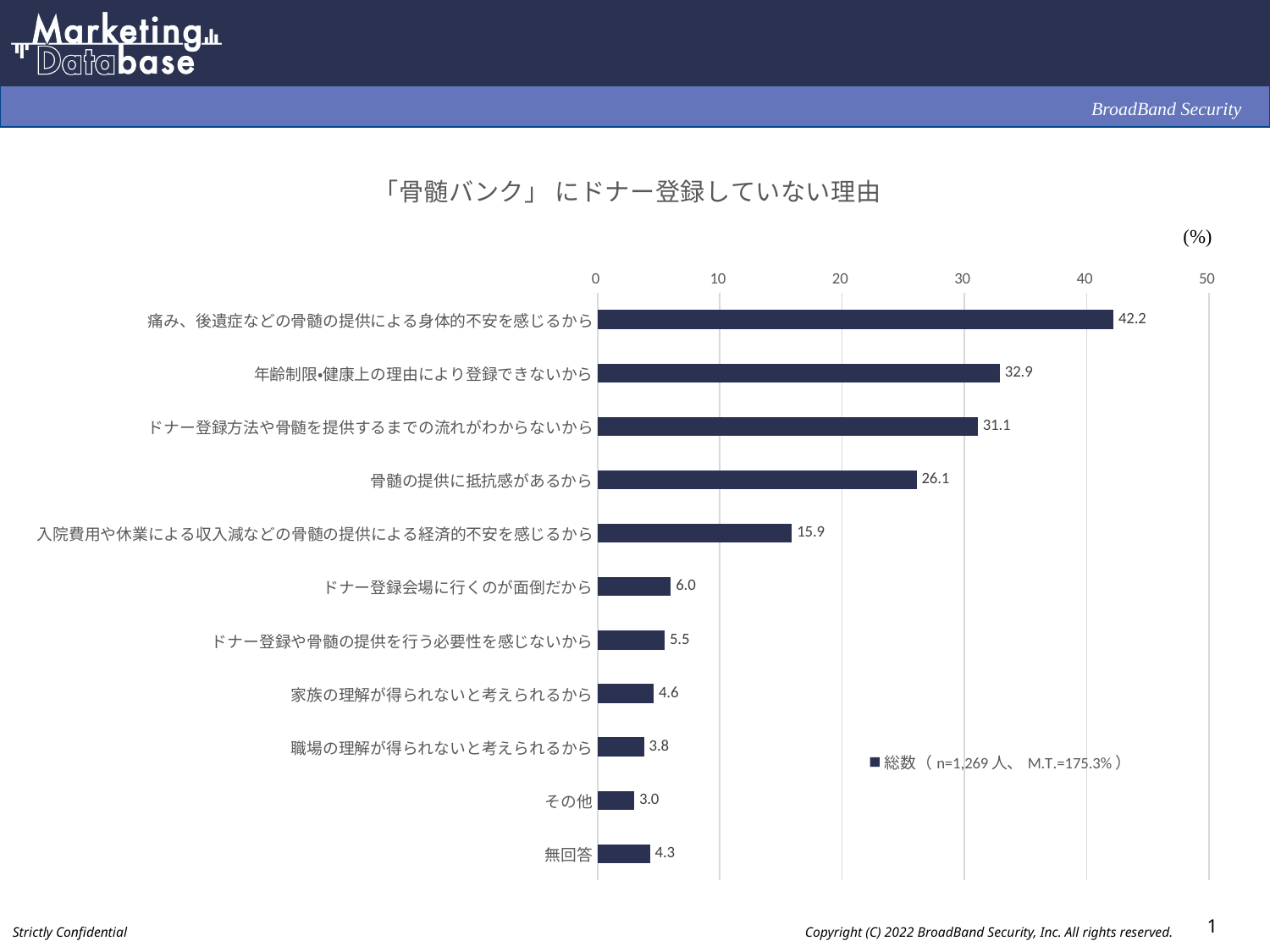
How many series does the legend list? 1 Is the value for 「入院費用や休業による収入減などの骨髄の提供による経済的不安を感じるから」 greater or less than 20? less What is the value for 「痛み、後遺症などの骨髄の提供による身体的不安を感じるから」? 42.2 Which category has the highest value? 痛み、後遺症などの骨髄の提供による身体的不安を感じるから How many categories are shown in the chart? 11 What is the value for 「骨髄の提供に抵抗感があるから」? 26.1 What is the difference between 「年齢制限•健康上の理由により登録できないから」 and 「ドナー登録方法や骨髄を提供するまでの流れがわからないから」? 1.8 Which category has the lowest value? その他 What is the value for 「無回答」? 4.3 What kind of chart is shown on the slide? bar chart Which is larger: 「ドナー登録会場に行くのが面倒だから」 or 「ドナー登録や骨髄の提供を行う必要性を感じないから」? ドナー登録会場に行くのが面倒だから What is the title of the chart? 「骨髄バンク」 にドナー登録していない理由